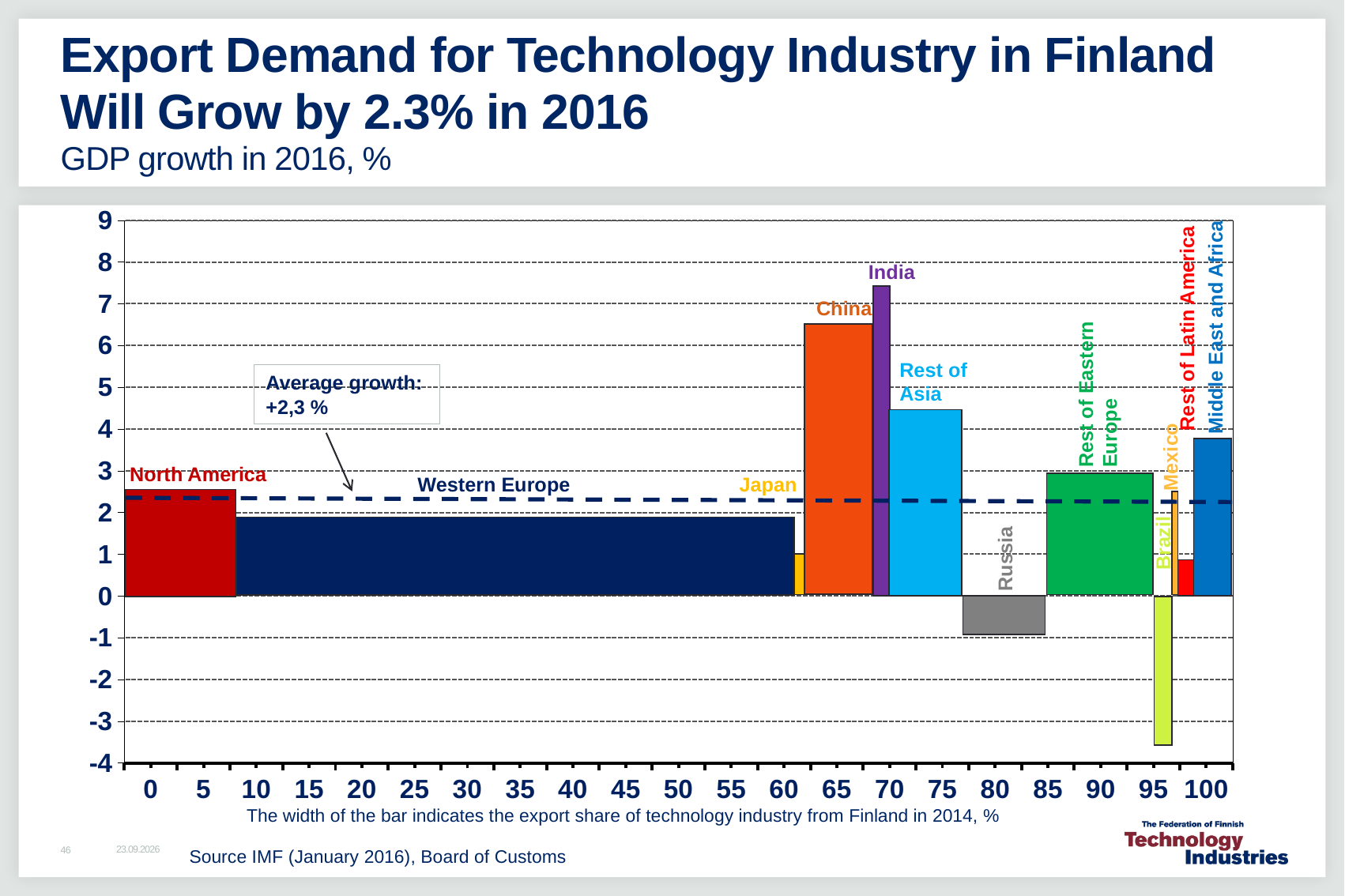
What average growth value is printed in the text box on the chart? +2,3 % How many regions are plotted as bars on the chart? 12 Is the GDP growth value for China greater or less than 6? greater Which region has the highest GDP growth in 2016 on the chart? India According to the note below the chart, what does the width of each bar indicate? The export share of technology industry from Finland in 2014, % Which has the higher GDP growth in 2016, China or Rest of Asia? China Which has the higher GDP growth in 2016, North America or Western Europe? North America Is the GDP growth value for Brazil greater or less than -3? less What kind of chart is shown on the slide? bar chart Is the GDP growth value for Russia greater or less than 0? less Which region has the lowest GDP growth in 2016 on the chart? Brazil